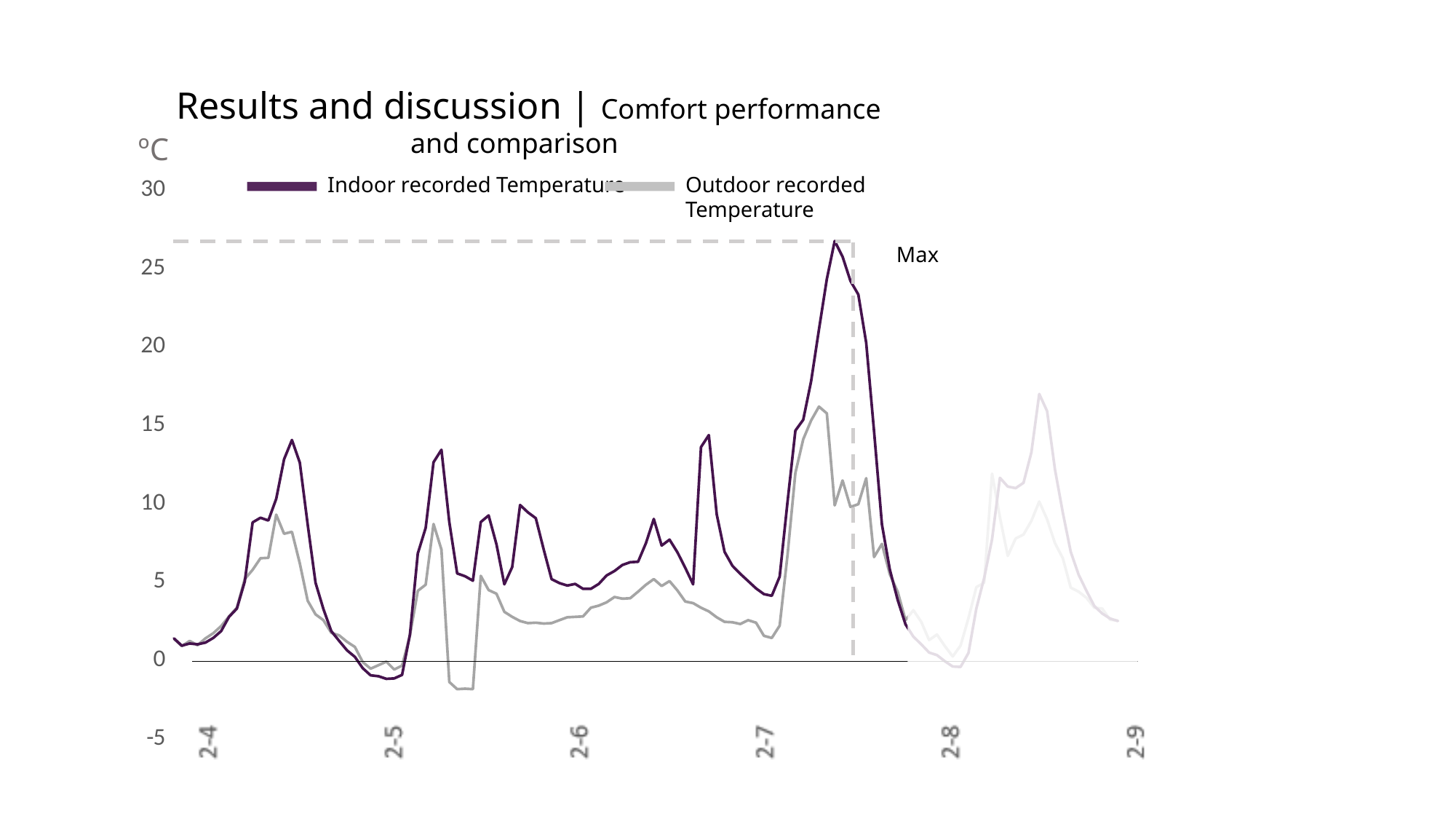
Is the peak value of the Outdoor recorded Temperature between 2-7 and 2-8 greater or less than 20? less What unit is shown on the y axis? °C Is the peak value of the Indoor recorded Temperature between 2-7 and 2-8 greater or less than 25? greater What kind of chart is shown on the slide? line chart Is the first peak of the Indoor recorded Temperature after 2-4 greater or less than 10? greater Does the Indoor recorded Temperature rise or fall from its highest peak toward 2-8? fall Which series reaches the highest value on the chart? Indoor recorded Temperature At the highest peak between 2-7 and 2-8, which series has the larger value, Indoor recorded Temperature or Outdoor recorded Temperature? Indoor recorded Temperature What are the two series named in the legend? Indoor recorded Temperature and Outdoor recorded Temperature How many date labels are shown on the x axis? 6 How many series does the legend list? 2